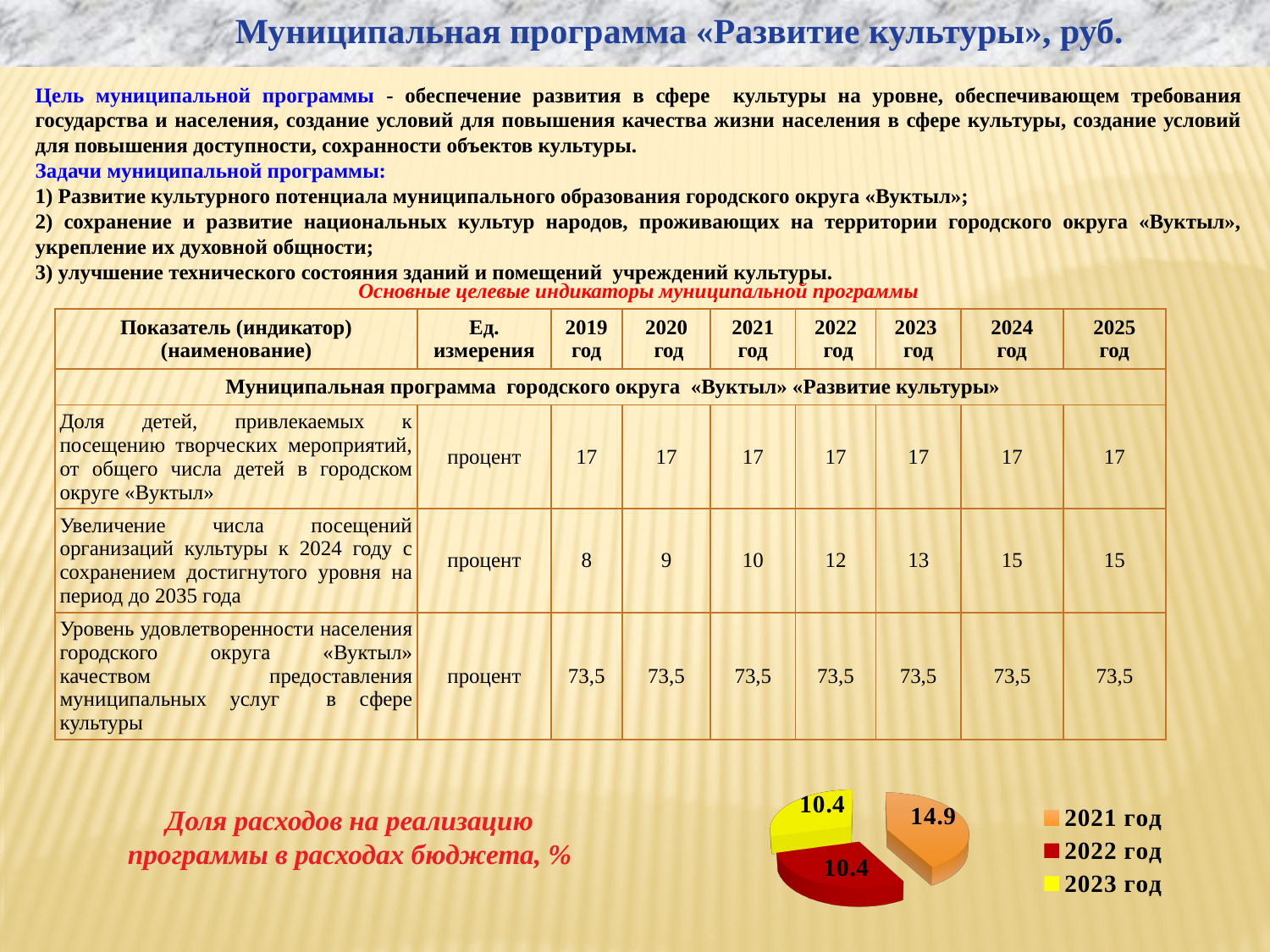
What colour represents 2023 год in the pie chart? yellow Which year has the largest slice in the pie chart? 2021 год What is the value for 2021 год in the pie chart? 14.9 How many entries does the legend of the pie chart list? 3 Which is larger in the pie chart, the value for 2021 год or the value for 2023 год? 2021 год What kind of chart is shown at the bottom of the slide? pie chart How many slices does the pie chart have? 3 What is the difference between the values for 2021 год and 2022 год in the pie chart? 4.5 What is the title of the chart at the bottom of the slide? Доля расходов на реализацию программы в расходах бюджета, % What is the value for 2023 год in the pie chart? 10.4 What is the value for 2022 год in the pie chart? 10.4